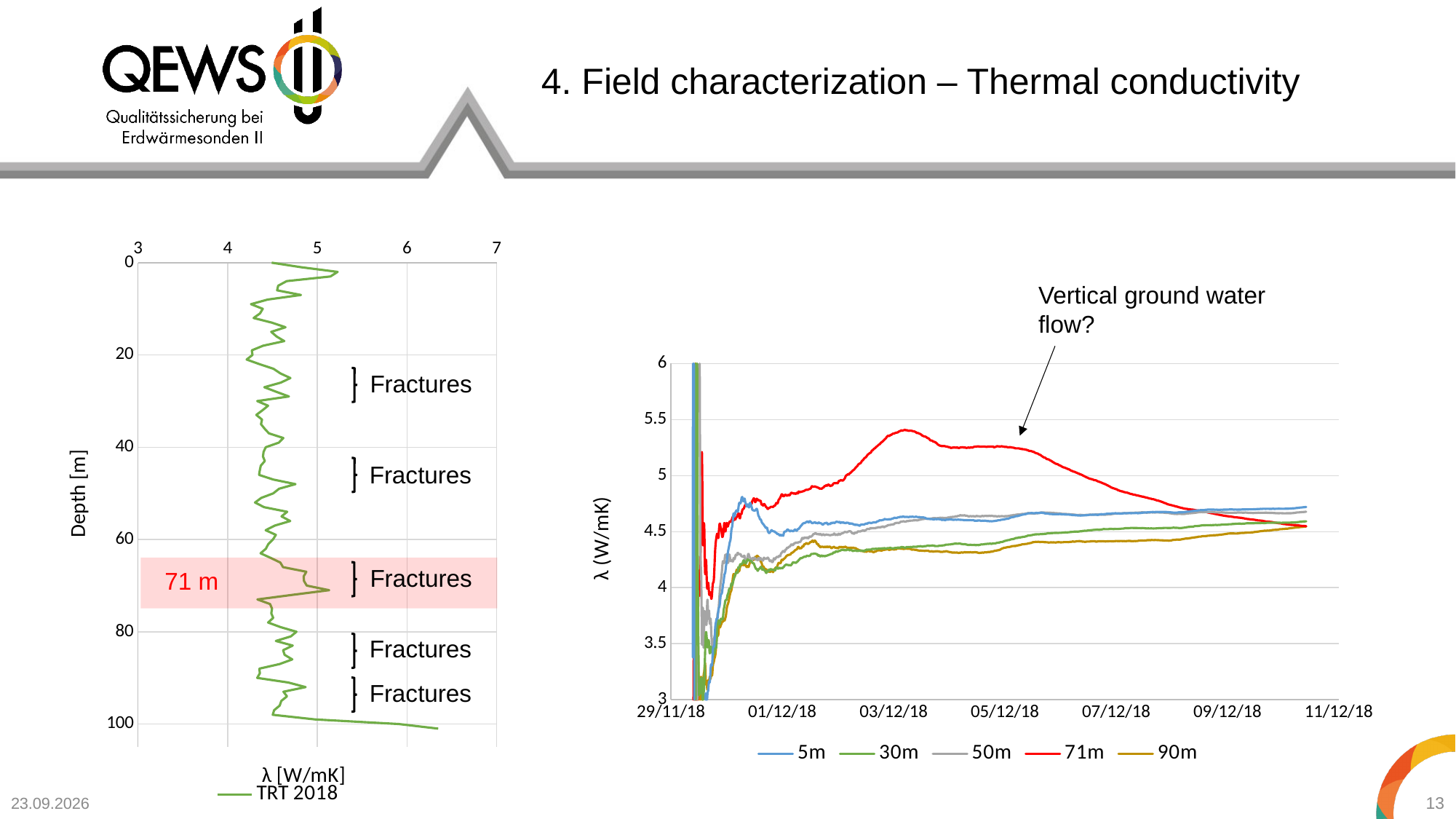
What kind of chart is the right chart (λ over time)? line chart On the right chart, does the 71m series rise or fall between 05/12/18 and 09/12/18? fall On the left chart, what is the legend entry for the plotted line? TRT 2018 On the right chart, is the value of the 90m series at 07/12/18 greater or less than 4.5? less On the right chart, how many series does the legend list? 5 On the right chart, at 05/12/18, which is larger: the 71m series or the 30m series? 71m On the right chart, is the peak value of the 71m series greater or less than 5? greater What kind of chart is the left chart (λ versus depth)? line chart On the left chart, how many 'Fractures' labels are marked along the depth profile? 5 On the left chart, what depth is highlighted in red? 71 m On the right chart, which series reaches the highest value between 03/12/18 and 05/12/18? 71m On the right chart, is the value of the 5m series at 09/12/18 greater or less than 4.5? greater